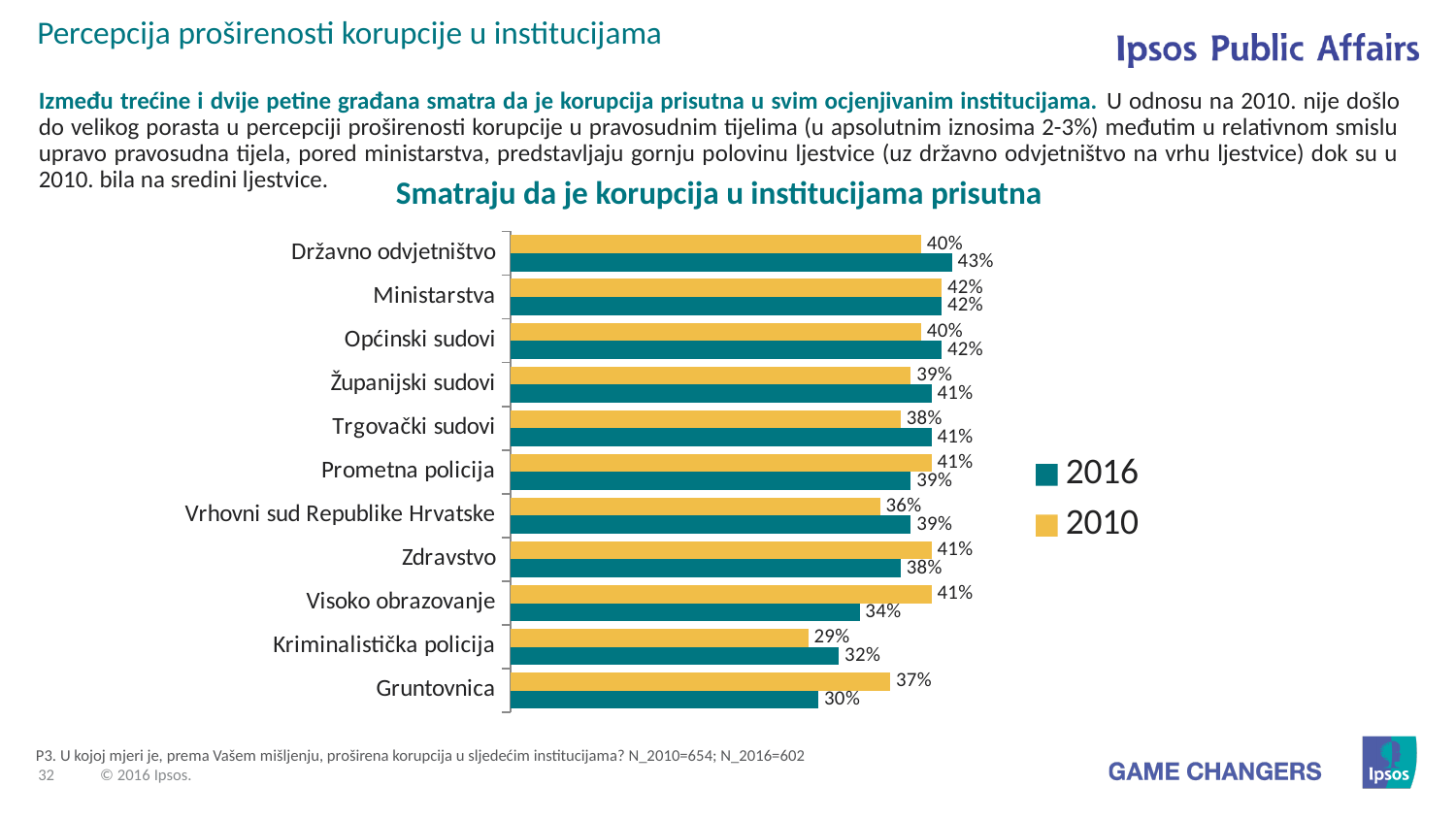
What type of chart is shown on the slide? Bar chart For Zdravstvo, which year has the larger value, 2016 or 2010? 2010 Which institution has the lowest 2010 value? Kriminalistička policija How many series does the legend list? 2 What is the 2010 value for Visoko obrazovanje? 41% Which institution has the lowest 2016 value? Gruntovnica What is the 2016 value for Državno odvjetništvo? 43% What is the 2016 value for Gruntovnica? 30% How many institutions are shown in the chart? 11 What is the difference between the 2016 and 2010 values for Državno odvjetništvo? 3% What is the difference between the 2010 and 2016 values for Visoko obrazovanje? 7% Which institution has the highest 2016 value? Državno odvjetništvo